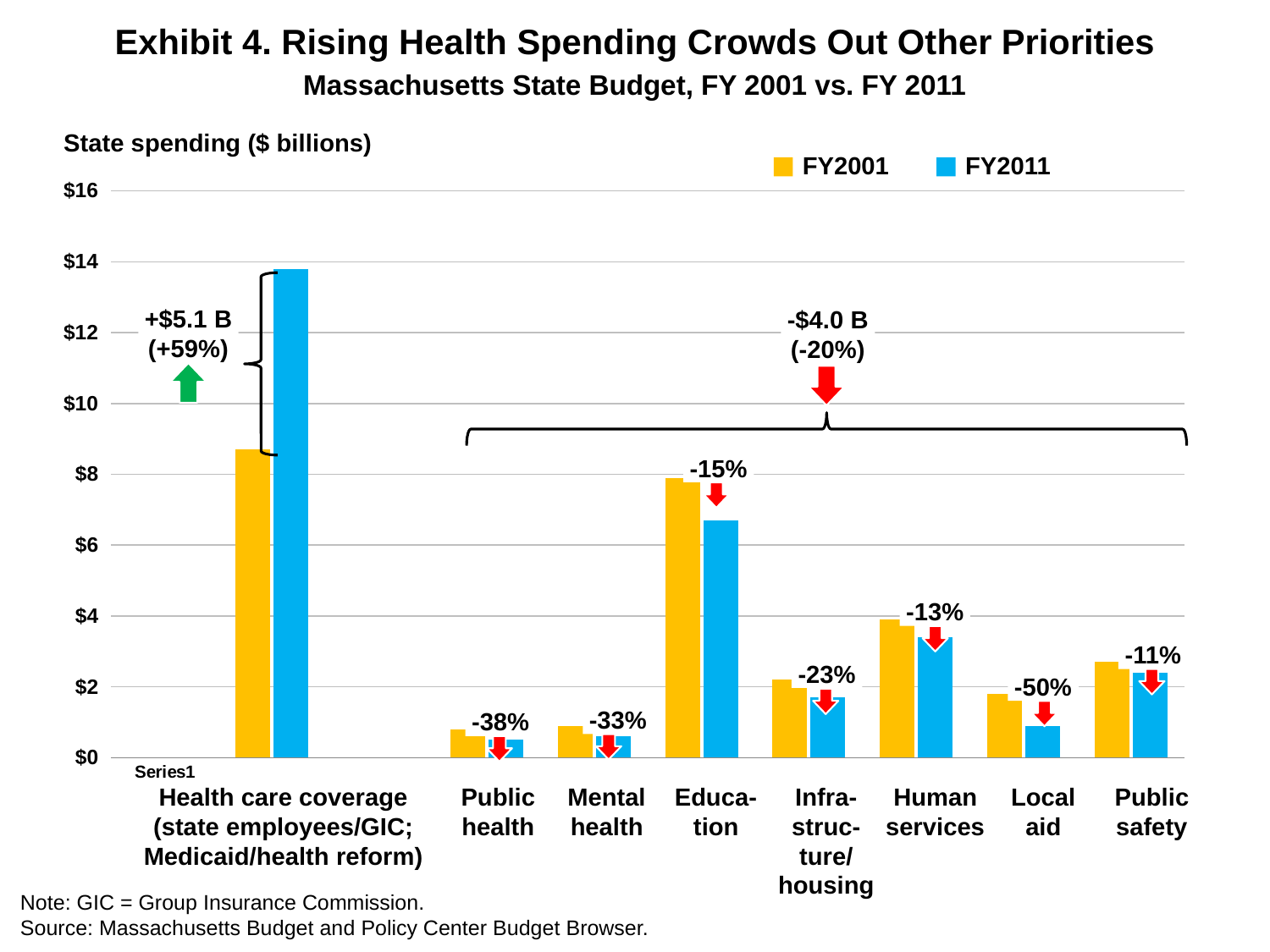
What kind of chart is shown on the slide? bar chart Is the FY2011 value for Local aid greater or less than $2? less What dollar and percentage change is annotated for the group of non-health categories? -$4.0 B (-20%) How many series does the legend list? 2 What percentage change is labeled for Local aid? -50% How many spending categories are shown along the x axis? 8 Is the FY2011 value for Health care coverage greater or less than $12? greater What dollar and percentage change is annotated for Health care coverage? +$5.1 B (+59%) What are the two series named in the legend? FY2001 and FY2011 Which category has the highest FY2011 bar? Health care coverage What percentage change is labeled for Public health? -38% For Education, which is larger, the FY2001 bar or the FY2011 bar? FY2001